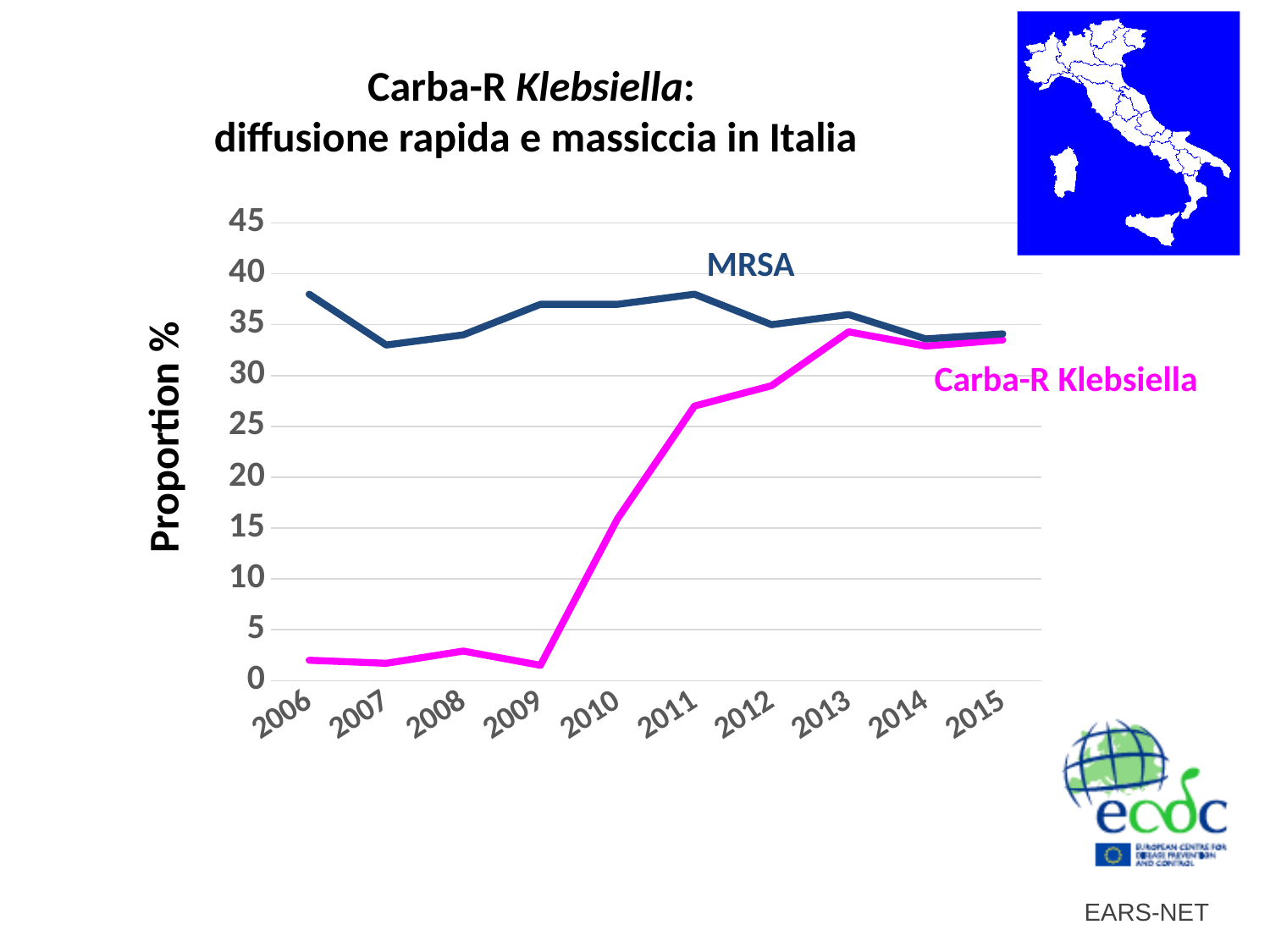
Is the value for Carba-R Klebsiella in 2013 greater or less than 30? greater Is the value for MRSA in 2006 greater or less than 35? greater What colour is the Carba-R Klebsiella line? magenta Is the value for Carba-R Klebsiella in 2011 greater or less than 25? greater What kind of chart is shown on the slide? line chart How many series are plotted on the chart? 2 What is the label of the y axis? Proportion % In 2010, which series has the higher value, MRSA or Carba-R Klebsiella? MRSA Does the Carba-R Klebsiella line rise or fall between 2009 and 2013? rise How many years are shown on the x axis of the chart? 10